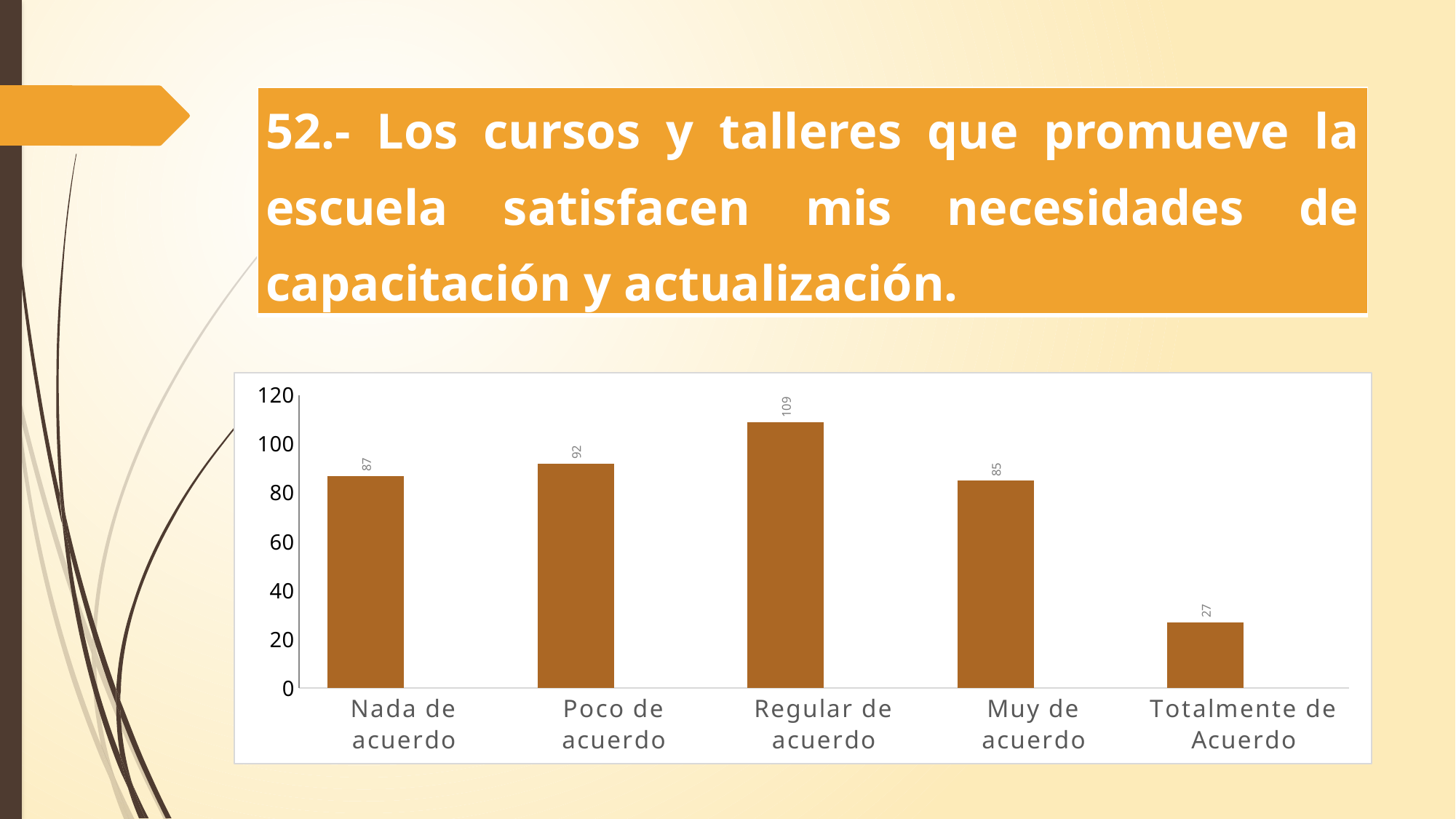
What is the value for "Totalmente de Acuerdo"? 27 Which category has the lowest value? Totalmente de Acuerdo What is the value for "Regular de acuerdo"? 109 How many categories are shown on the x axis? 5 Which is larger, the value for "Nada de acuerdo" or the value for "Muy de acuerdo"? Nada de acuerdo Which category has the highest value? Regular de acuerdo What is the difference between the values for "Regular de acuerdo" and "Totalmente de Acuerdo"? 82 What is the highest value shown on the y axis? 120 What is the difference between the values for "Poco de acuerdo" and "Nada de acuerdo"? 5 Is the value for "Muy de acuerdo" greater or less than 100? less What is the value for "Poco de acuerdo"? 92 What kind of chart is shown on the slide? bar chart